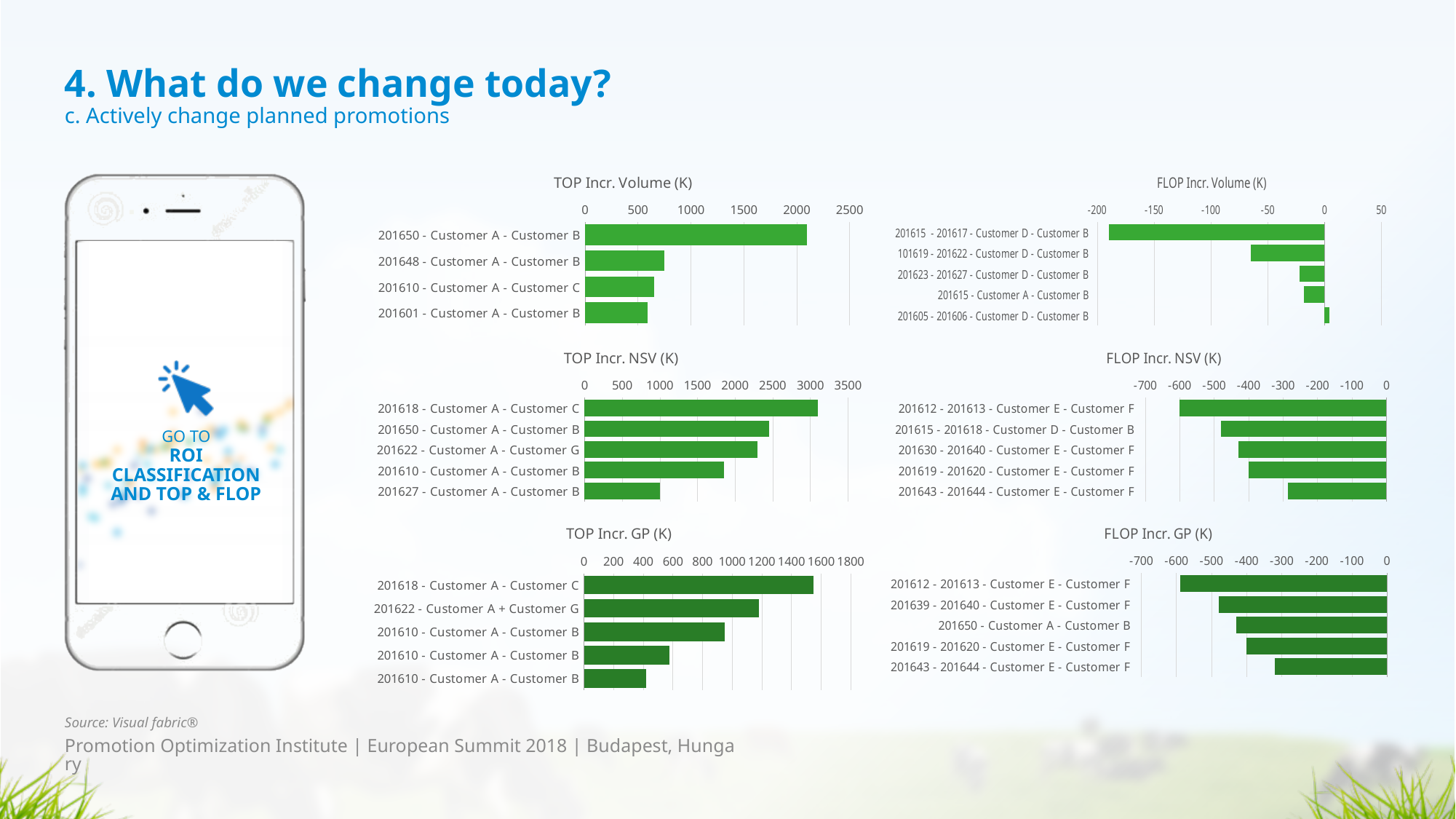
In the TOP Incr. Volume (K) chart, which category has the highest value? 201650 - Customer A - Customer B How many charts are shown on the slide? 6 In the FLOP Incr. NSV (K) chart, which has the more negative value: 201612 - 201613 - Customer E - Customer F or 201643 - 201644 - Customer E - Customer F? 201612 - 201613 - Customer E - Customer F What kind of chart is the TOP Incr. GP (K) chart? bar chart In the FLOP Incr. Volume (K) chart, is the value for 201615 - 201617 - Customer D - Customer B greater or less than -150? less How many categories are shown in the FLOP Incr. NSV (K) chart? 5 In the TOP Incr. NSV (K) chart, which category has the highest value? 201618 - Customer A - Customer C In the TOP Incr. Volume (K) chart, is the value for 201650 - Customer A - Customer B greater or less than 2000? greater In the TOP Incr. GP (K) chart, is the value for 201618 - Customer A - Customer C greater or less than 1400? greater In the TOP Incr. NSV (K) chart, which category has the lowest value? 201627 - Customer A - Customer B How many categories are shown in the TOP Incr. Volume (K) chart? 4 In the FLOP Incr. Volume (K) chart, which category has the lowest (most negative) value? 201615 - 201617 - Customer D - Customer B